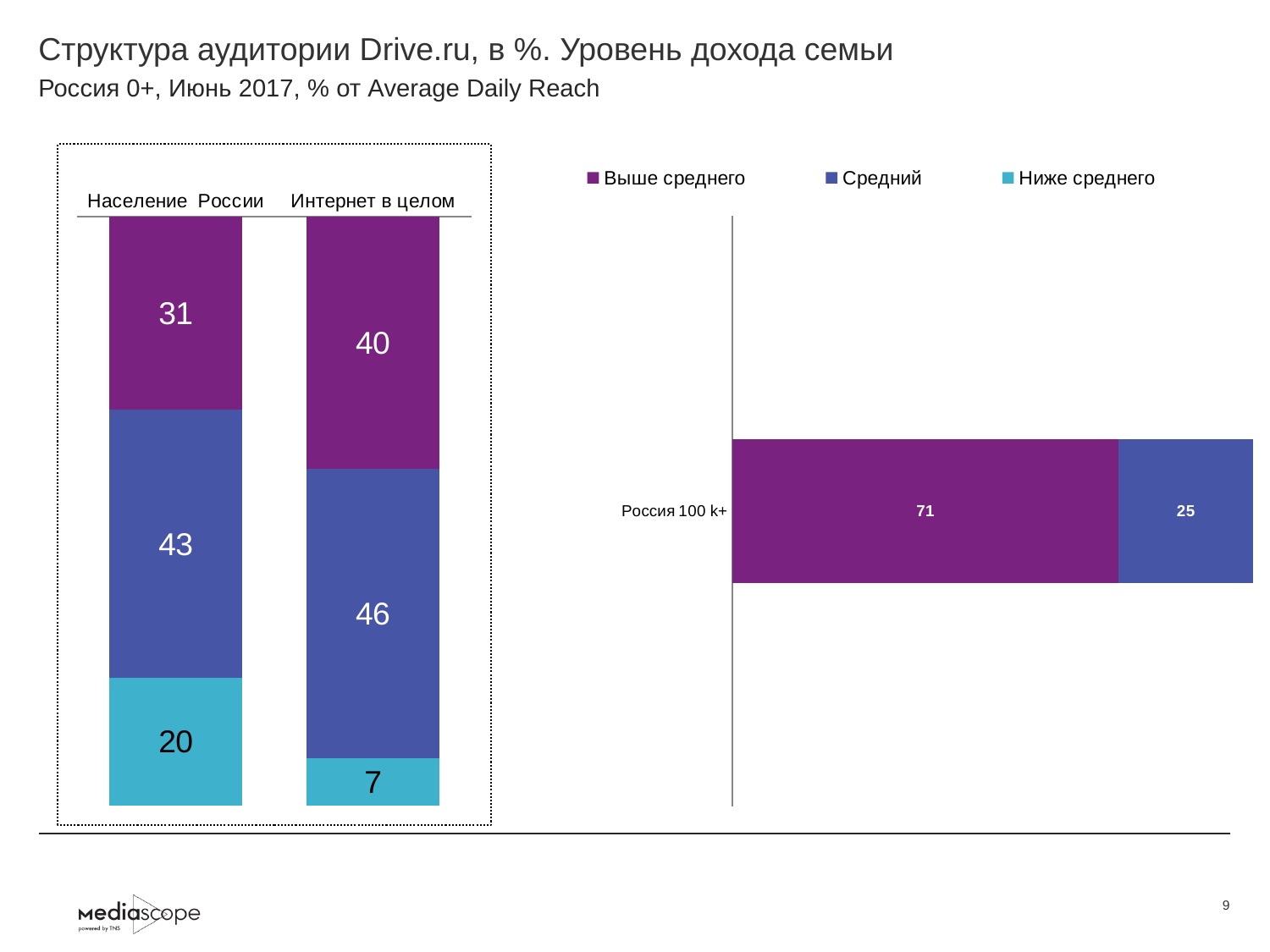
In the left chart, what is the value of the Средний segment for Интернет в целом? 46 In the left chart, which has a larger Выше среднего value: Население России or Интернет в целом? Интернет в целом In the right chart, what is the value of the Выше среднего segment for Россия 100 k+? 71 In the right chart, what is the value of the Средний segment for Россия 100 k+? 25 How many series does the legend list? 3 In the left chart, which segment is the smallest for Интернет в целом? Ниже среднего In the left chart, which segment is the largest for Население России? Средний In the left chart, what is the value of the Выше среднего segment for Население России? 31 In the left chart, what is the value of the Ниже среднего segment for Интернет в целом? 7 In the left chart, what is the difference between the Ниже среднего values for Население России and Интернет в целом? 13 What type of chart is the right chart? Stacked bar chart In the left chart, what is the total of the stacked bar for Население России? 94